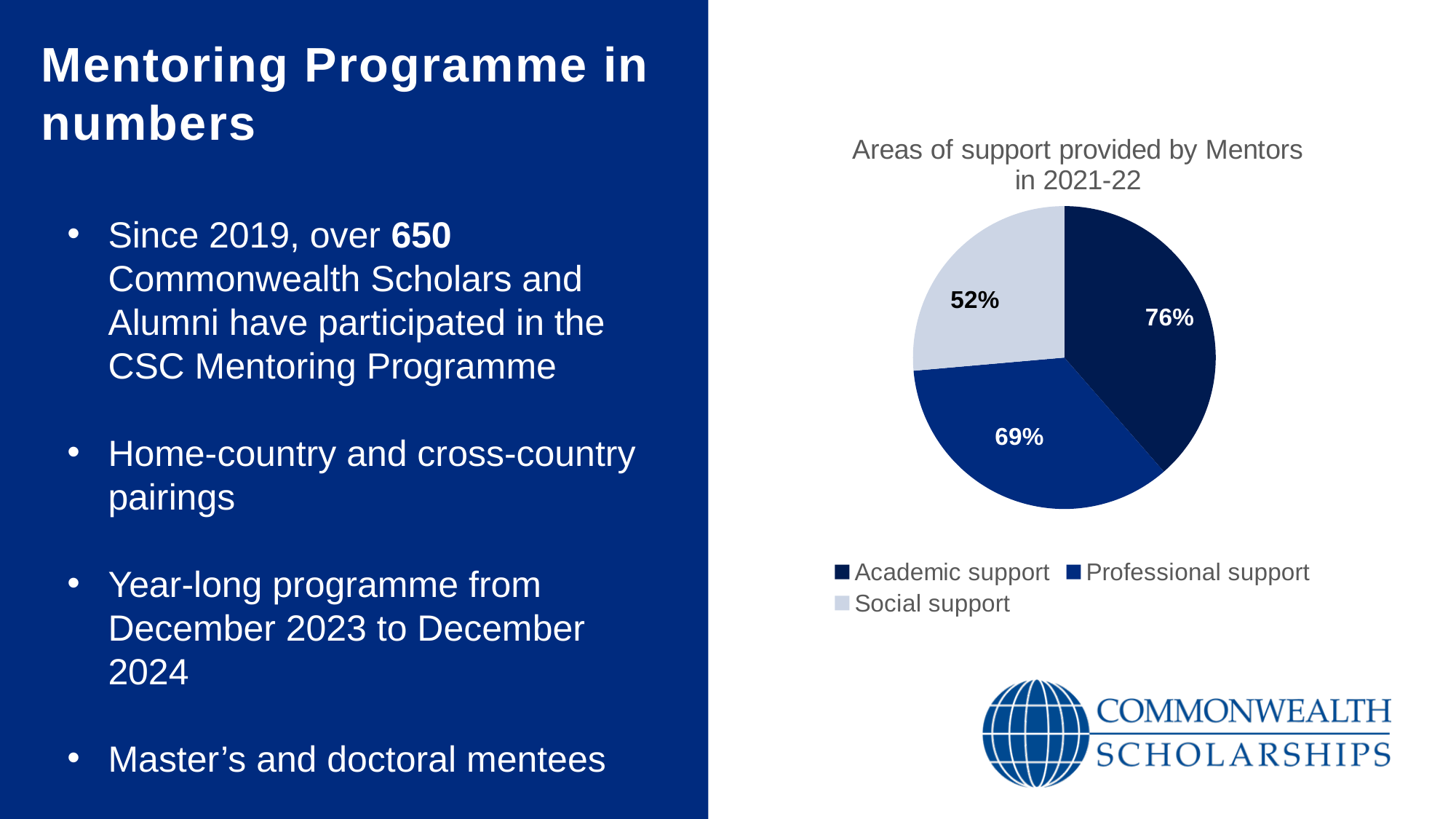
What value is shown for Social support? 52% What value is shown for Professional support? 69% What is the difference between the values for Academic support and Social support? 24 percentage points What value is shown for Academic support? 76% Which is larger, the value for Academic support or the value for Professional support? Academic support What is the title of the chart? Areas of support provided by Mentors in 2021-22 Which area of support has the highest value? Academic support How many slices does the pie chart have? 3 How many entries does the legend list? 3 What type of chart is shown on the slide? Pie chart What is the difference between the values for Professional support and Social support? 17 percentage points Which area of support has the lowest value? Social support